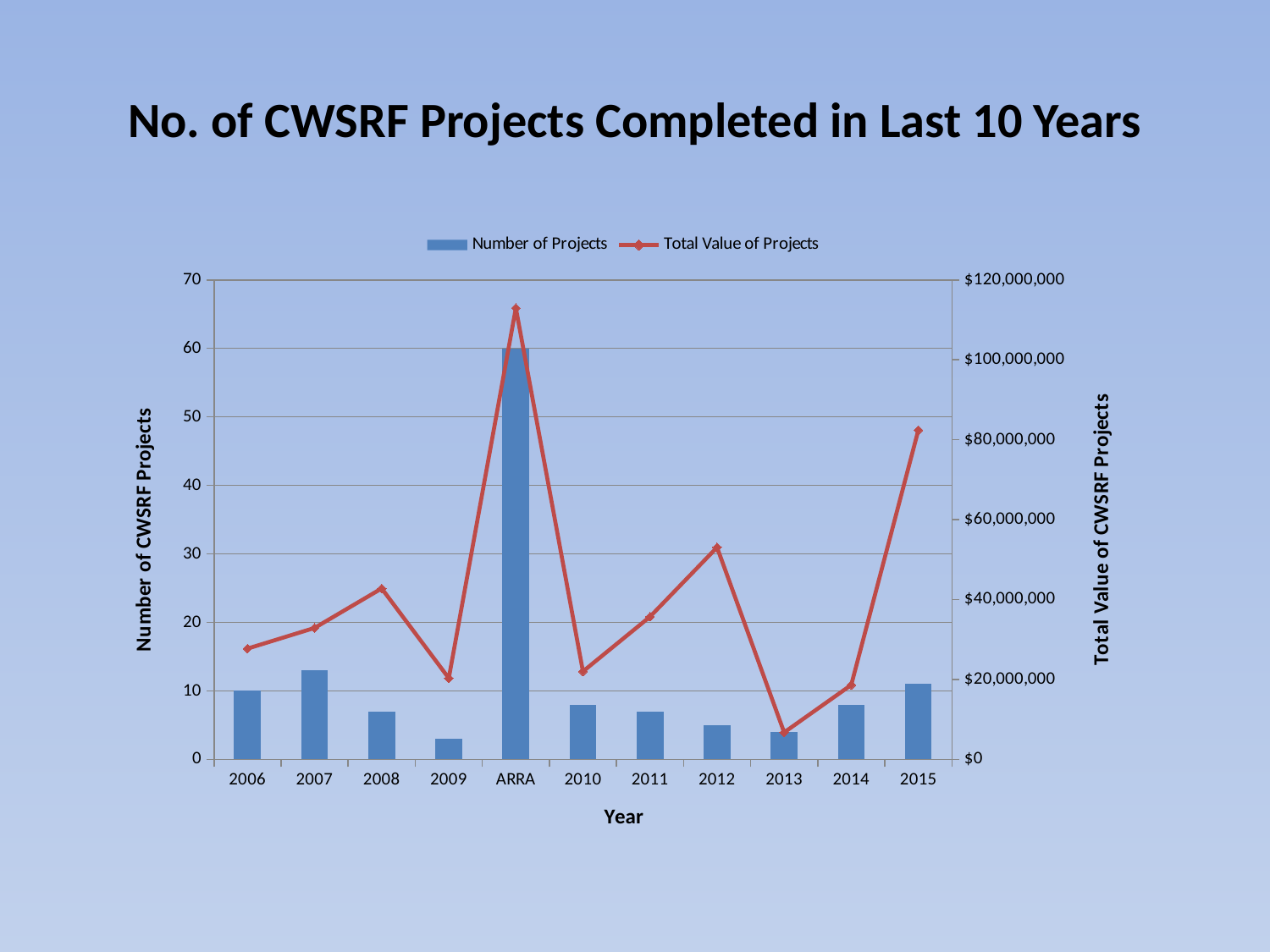
How many series does the legend list? 2 What is the number of projects for ARRA? 60 Is the number of projects for 2015 greater or less than 20? less Does the total value of projects rise or fall from 2013 to 2015? rise What kind of chart is shown on the slide? A bar chart combined with a line chart Which year has the lowest total value of projects? 2013 Is the total value of projects for 2015 greater or less than $60,000,000? greater Which year has the lowest number of projects? 2009 Which year has more projects, 2007 or 2008? 2007 Which category has the highest number of projects? ARRA Which category has the highest total value of projects? ARRA How many categories are shown along the x axis? 11